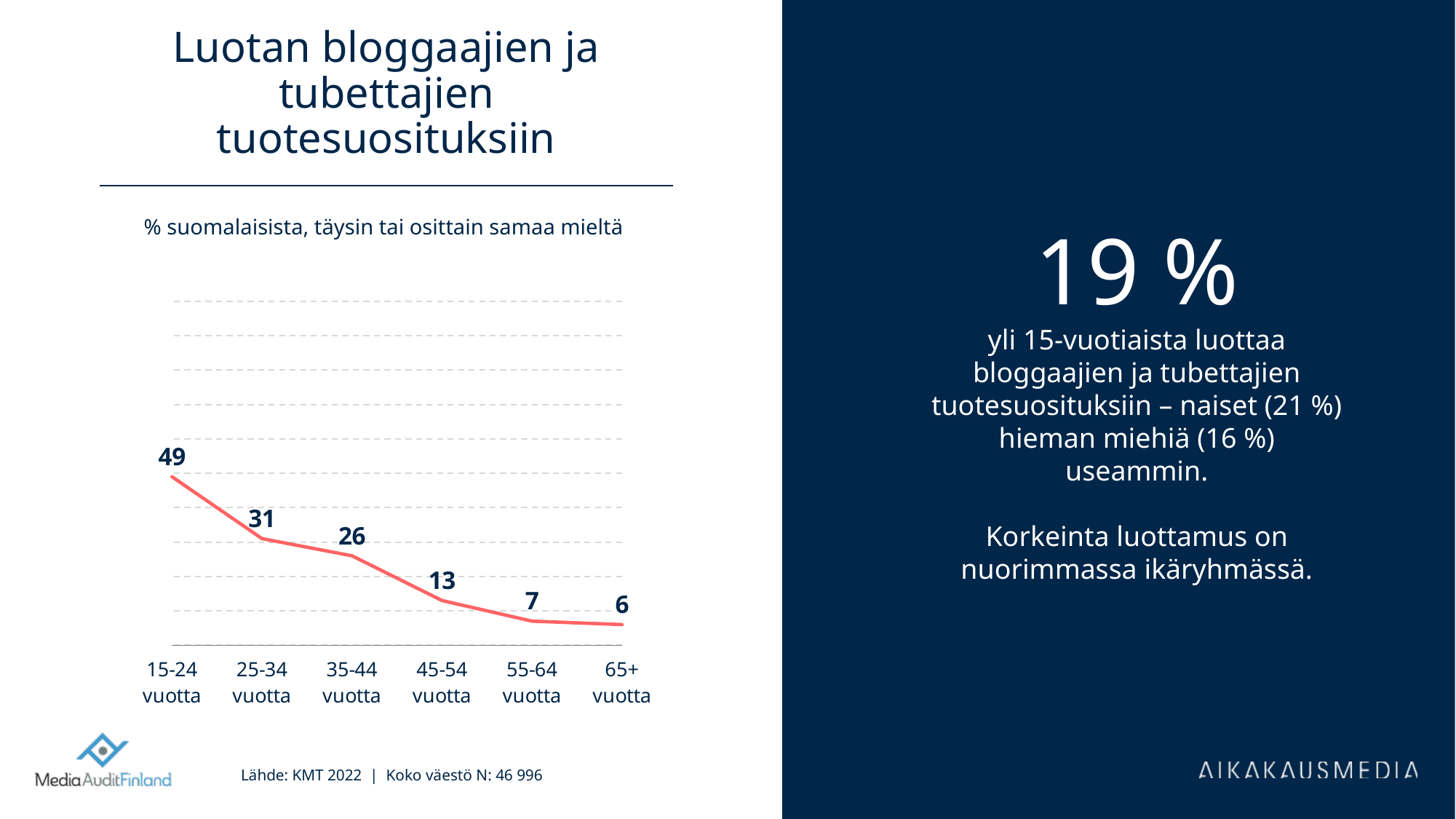
Which is larger, the value for 25-34 vuotta or the value for 35-44 vuotta? 25-34 vuotta What is the subtitle shown above the chart? % suomalaisista, täysin tai osittain samaa mieltä What is the difference between the values for 35-44 vuotta and 45-54 vuotta? 13 How many age groups are plotted on the chart? 6 What is the difference between the values for 15-24 vuotta and 25-34 vuotta? 18 What is the value for the 15-24 vuotta age group? 49 What kind of chart is shown on the slide? line chart Which age group has the highest value? 15-24 vuotta Do the values rise or fall as age increases along the x axis? fall What is the value for the 65+ vuotta age group? 6 What is the value for the 45-54 vuotta age group? 13 Which age group has the lowest value? 65+ vuotta